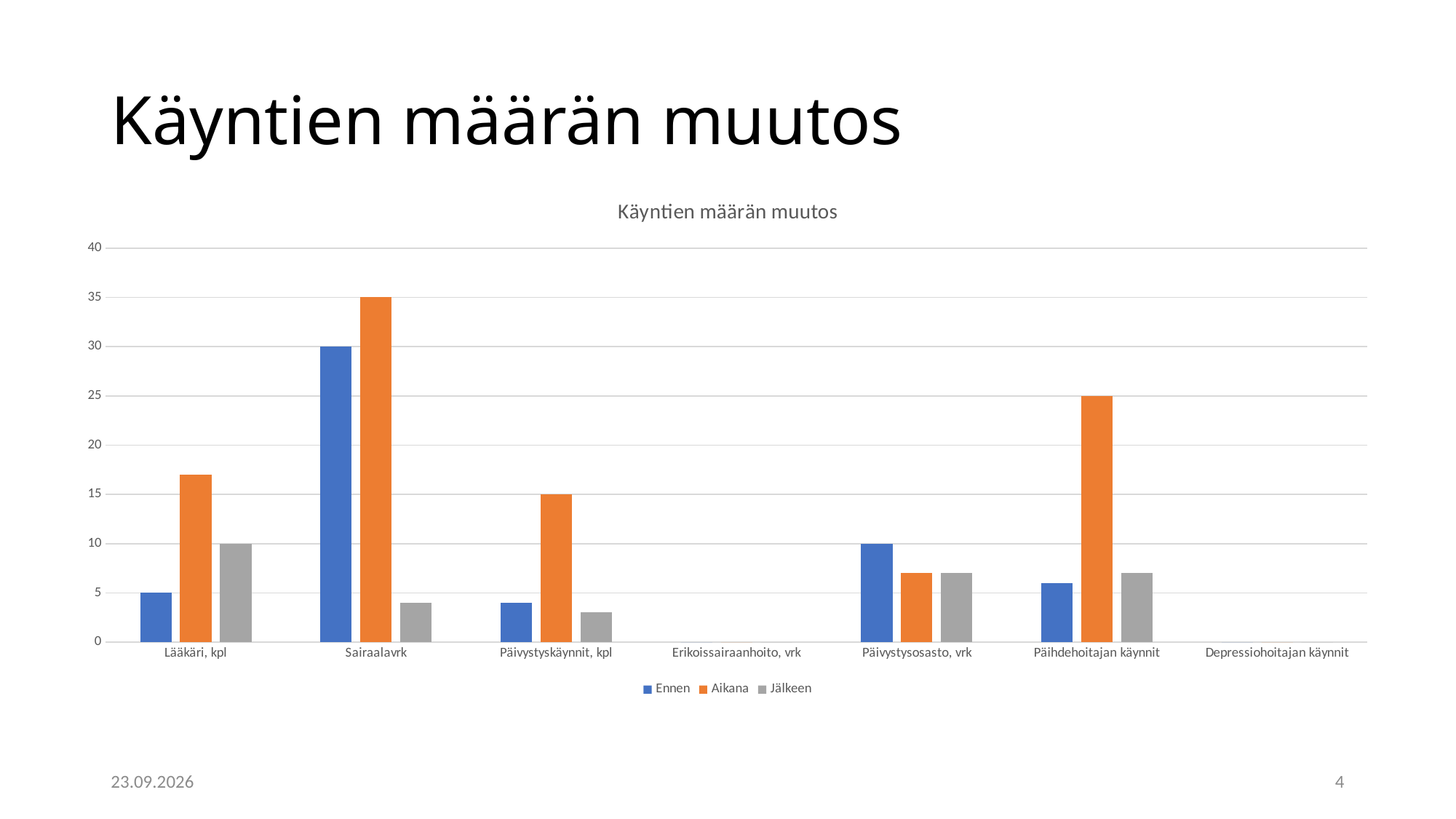
What is the Aikana value for Päihdehoitajan käynnit? 25 Is the Jälkeen value for Sairaalavrk greater or less than 5? less What is the Ennen value for Sairaalavrk? 30 What is the difference between the Aikana and Ennen values for Sairaalavrk? 5 What is the Ennen value for Päivystysosasto, vrk? 10 What kind of chart is shown on the slide? bar chart How many categories are shown on the x axis? 7 Which is larger for Päivystyskäynnit, kpl: the Ennen value or the Aikana value? Aikana Is the Aikana value for Lääkäri, kpl greater or less than 15? greater How many series does the legend list? 3 Which category has the highest Aikana value? Sairaalavrk What is the Aikana value for Sairaalavrk? 35